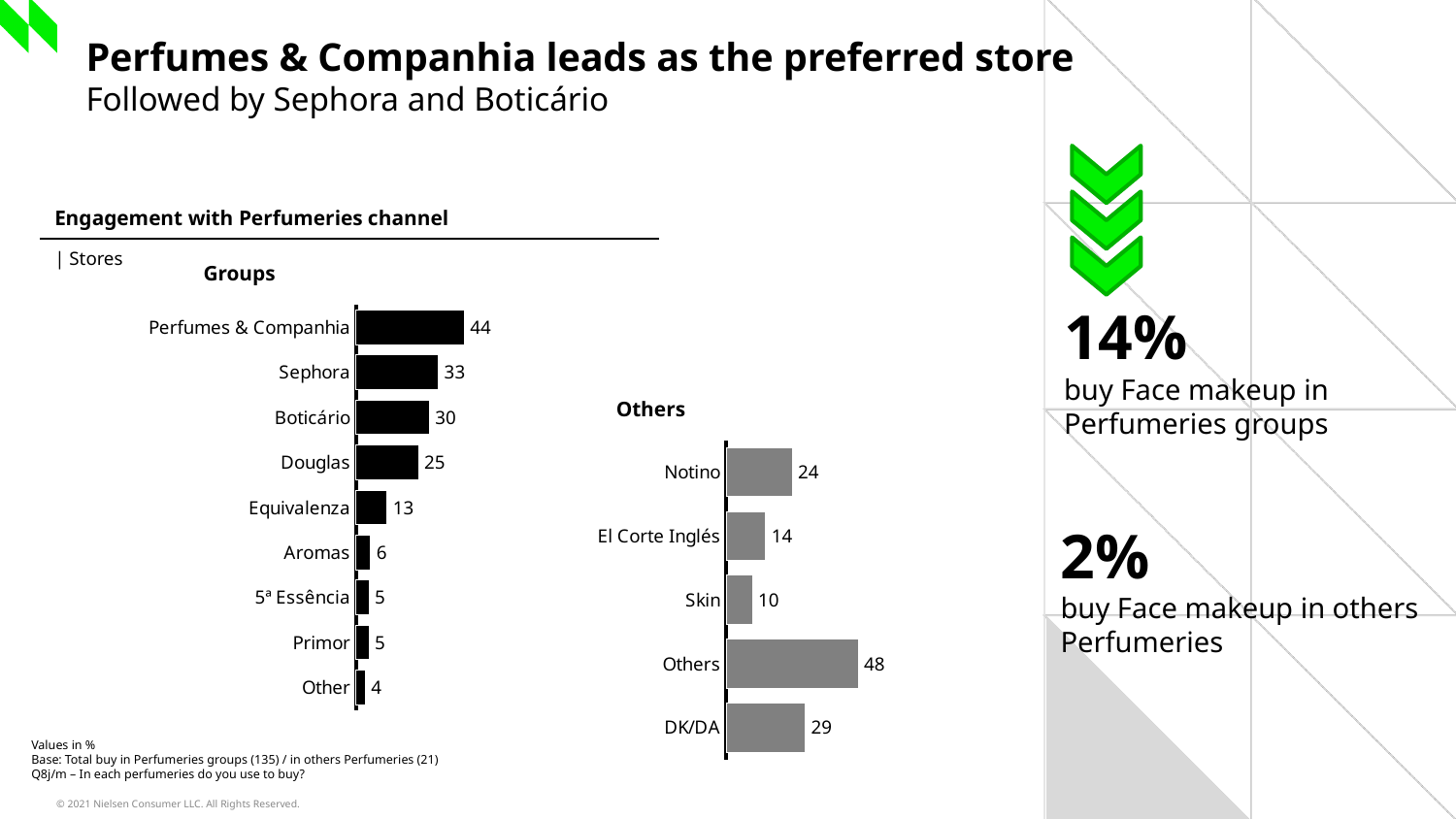
In the Groups chart, what is the difference between Perfumes & Companhia and Boticário? 14 In the Others chart, which is larger, El Corte Inglés or Skin? El Corte Inglés In the Others chart, which category has the highest value? Others How many stores are shown in the Groups chart? 9 What type of chart is the Others chart? Bar chart In the Others chart, what is the value for DK/DA? 29 In the Groups chart, which store has the lowest value? Other In the Groups chart, what is the value for Sephora? 33 In the Others chart, what is the value for Notino? 24 In the Others chart, which category has the lowest value? Skin In the Groups chart, which store has the highest value? Perfumes & Companhia In the Groups chart, what is the value for Douglas? 25